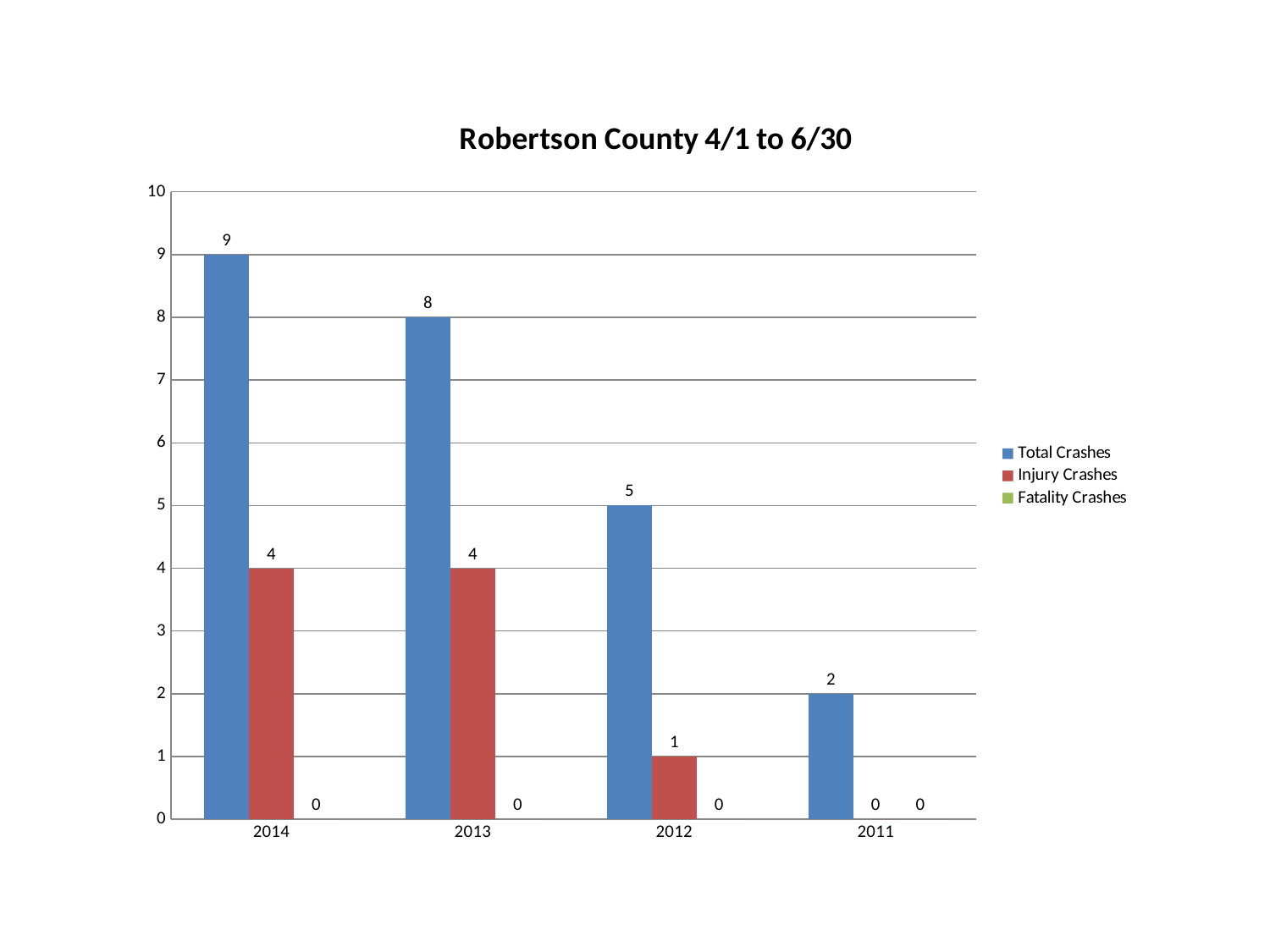
What is the value of Injury Crashes for 2012? 1 What is the title of the chart? Robertson County 4/1 to 6/30 What kind of chart is shown? Bar chart Which year has the lowest Total Crashes? 2011 What is the difference between Total Crashes in 2013 and 2012? 3 How many series does the legend list? 3 Which year has the highest Total Crashes? 2014 Do Total Crashes rise or fall from 2014 to 2011 along the x axis? Fall What is the value of Total Crashes for 2014? 9 Which is larger, Injury Crashes in 2013 or Injury Crashes in 2012? Injury Crashes in 2013 What is the value of Injury Crashes for 2011? 0 How many years are shown on the x axis? 4